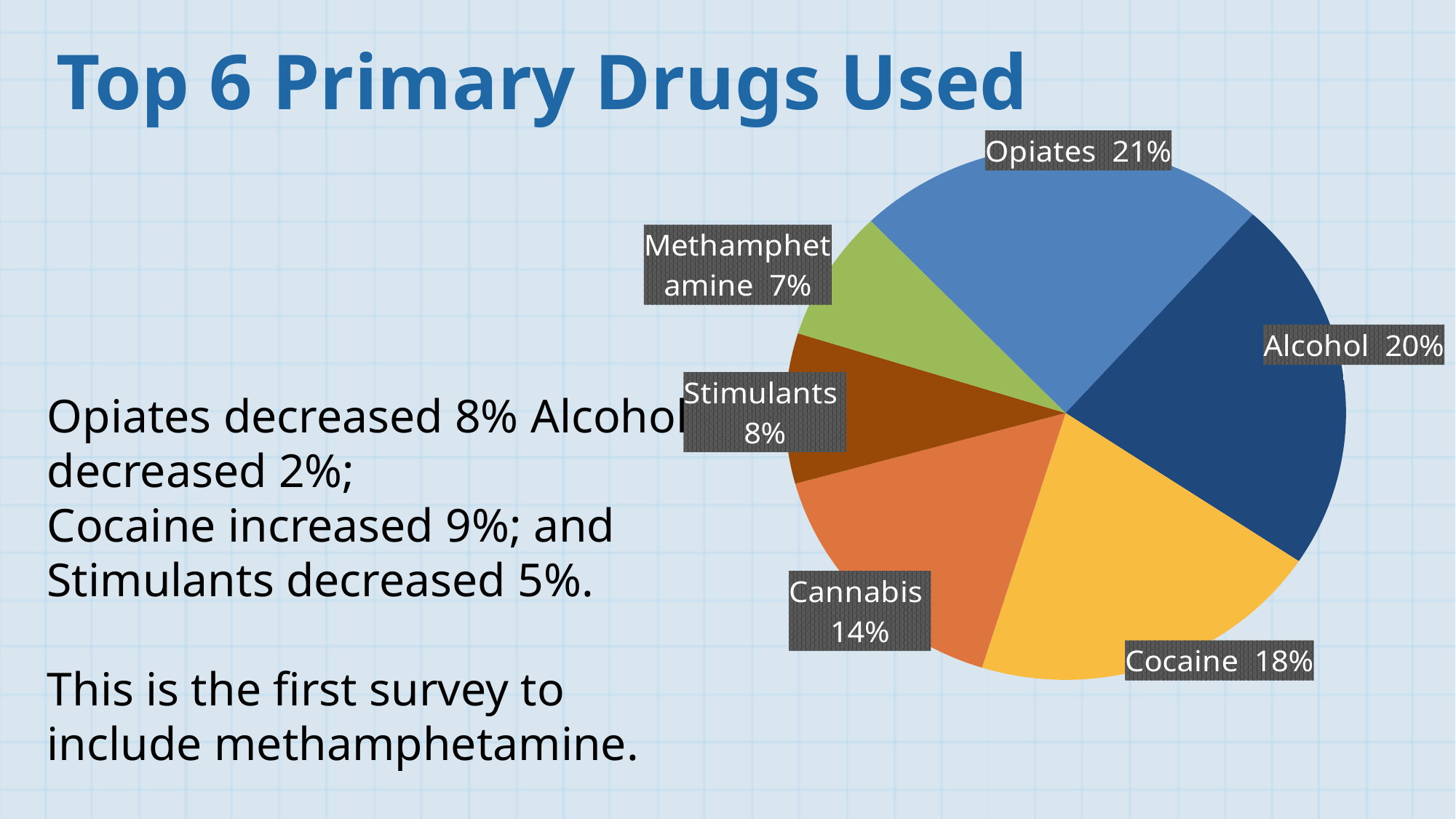
Which drug has the smallest slice of the pie? Methamphetamine What colour is the Cocaine slice of the pie? Yellow What is the difference in percentage points between Stimulants and Methamphetamine? 1 What is the title of the slide containing the pie chart? Top 6 Primary Drugs Used What percentage of the pie is Opiates? 21% What is the difference in percentage points between Cocaine and Cannabis? 4 What percentage of the pie is Cannabis? 14% How many slices does the pie chart have? 6 Which is larger, the Alcohol slice or the Cocaine slice? Alcohol Which drug has the largest slice of the pie? Opiates What kind of chart is shown on the slide? Pie chart What percentage of the pie is Methamphetamine? 7%